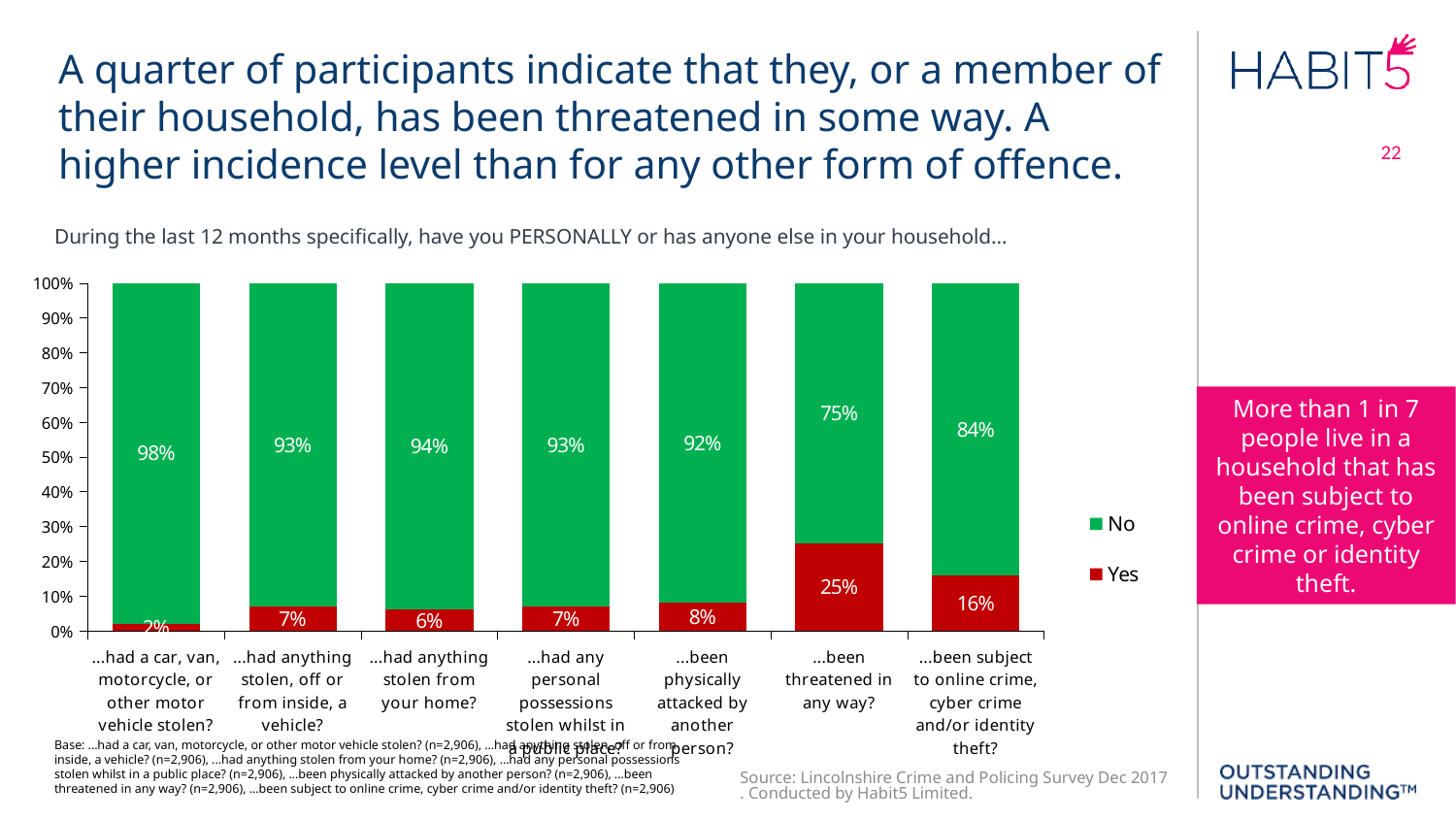
What is the Yes value for being subject to online crime, cyber crime and/or identity theft? 16% Which category has the highest Yes percentage? ...been threatened in any way? What percentage of participants answered Yes to having been threatened in any way? 25% Which colour represents the Yes responses in the chart? Red What type of chart is shown on the slide? Stacked bar chart How many categories are shown on the x axis of the chart? 7 How many series does the chart legend list? 2 Which is larger: the Yes value for having anything stolen from your home or the Yes value for having been physically attacked by another person? ...been physically attacked by another person? What percentage of participants answered No to having had a car, van, motorcycle, or other motor vehicle stolen? 98% What is the Yes value for having been physically attacked by another person? 8% Which category has the lowest Yes percentage? ...had a car, van, motorcycle, or other motor vehicle stolen? What is the difference between the Yes percentage for being threatened in any way and the Yes percentage for being subject to online crime, cyber crime and/or identity theft? 9%